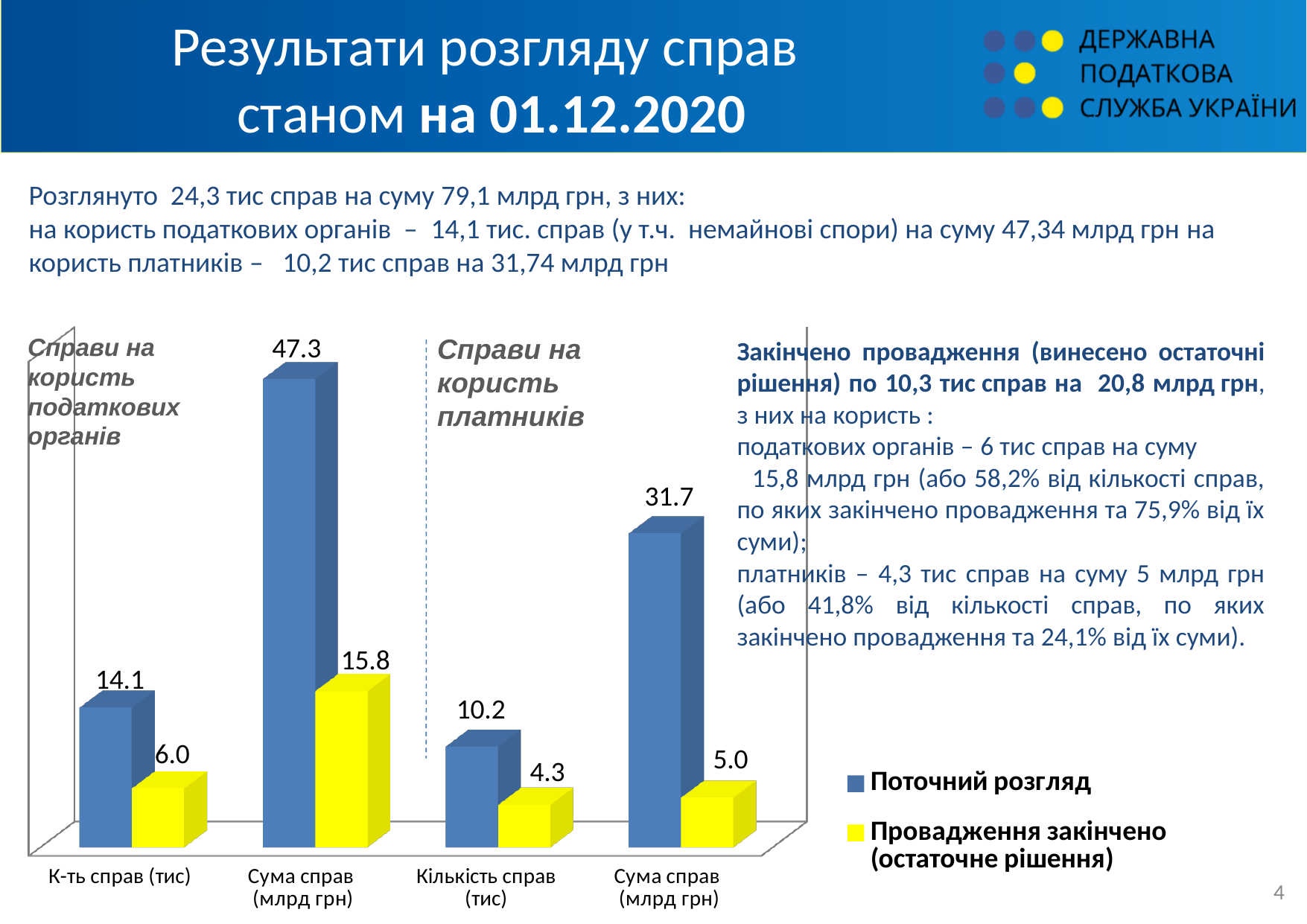
What is the difference between the "Поточний розгляд" and "Провадження закінчено (остаточне рішення)" values for "Сума справ (млрд грн)" in the "Справи на користь платників" group? 26.7 Which category has the highest "Поточний розгляд" value? Сума справ (млрд грн) (Справи на користь податкових органів) What is the value of "Поточний розгляд" for "Кількість справ (тис)" in the "Справи на користь платників" group? 10.2 What colour are the bars for the "Провадження закінчено (остаточне рішення)" series? yellow How many series does the chart legend list? 2 How many categories are shown along the x axis of the chart? 4 What kind of chart is shown on the slide? bar chart Which is larger: the "Поточний розгляд" value for "К-ть справ (тис)" (податкових органів) or for "Кількість справ (тис)" (платників)? К-ть справ (тис) (податкових органів) What is the value of "Провадження закінчено (остаточне рішення)" for "Сума справ (млрд грн)" in the "Справи на користь платників" group? 5.0 Which category has the lowest "Провадження закінчено (остаточне рішення)" value? Кількість справ (тис) (Справи на користь платників) What is the value of "Провадження закінчено (остаточне рішення)" for "Сума справ (млрд грн)" in the "Справи на користь податкових органів" group? 15.8 What is the value of "Поточний розгляд" for "К-ть справ (тис)" in the "Справи на користь податкових органів" group? 14.1